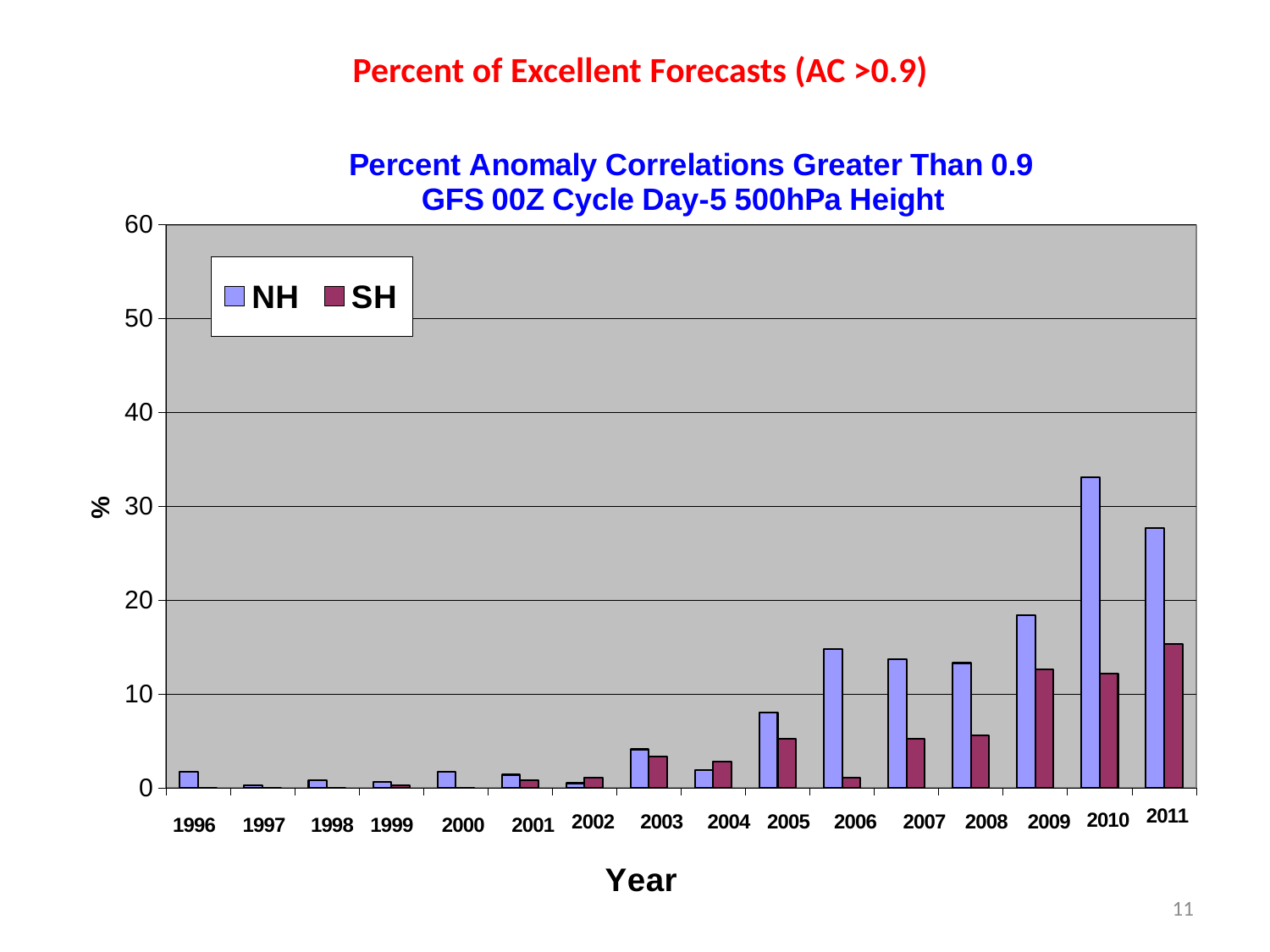
How many years are shown along the x axis? 16 Is the NH value for 2009 greater or less than 20? less Is the SH value for 2006 greater or less than 10? less In 2006, which series has the larger value, NH or SH? NH What kind of chart is shown on the slide? bar chart In 2004, which series has the larger value, NH or SH? SH In which year is the SH value highest? 2011 Is the NH value for 2010 greater or less than 30? greater Overall, do the NH values rise or fall from 1996 to 2011? rise How many series does the legend list? 2 In which year is the NH value highest? 2010